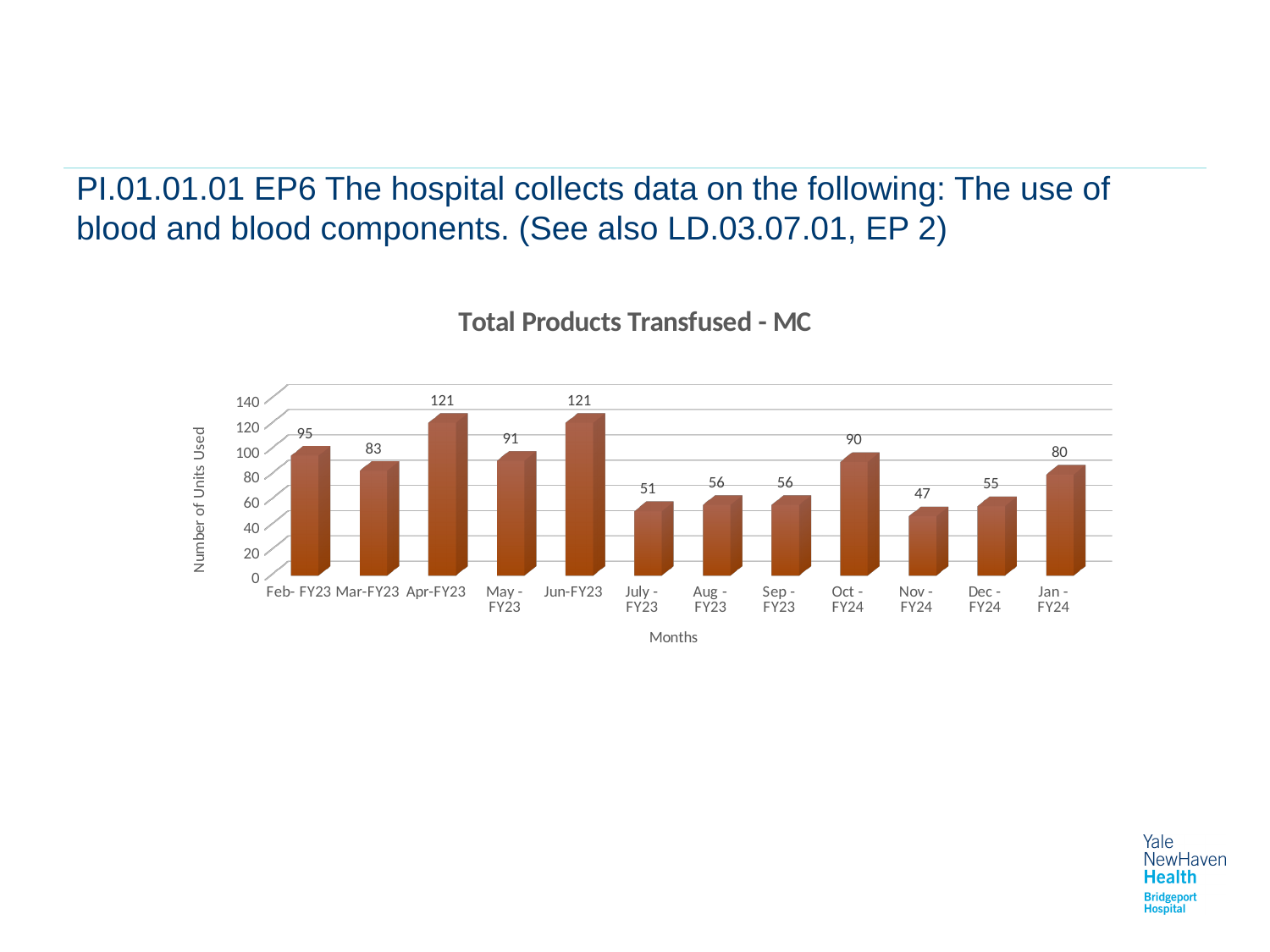
What is the title of the chart? Total Products Transfused - MC What is the highest value shown on the chart? 121 What is the difference between the units used in Apr-FY23 and Mar-FY23? 38 Which month has the lowest number of units used? Nov-FY24 How many months are plotted on the chart? 12 What type of chart is shown on the slide? bar chart What is the label of the vertical axis? Number of Units Used What is the number of units used in Nov-FY24? 47 Which is larger, the value for Jan-FY24 or the value for Dec-FY24? Jan-FY24 What is the number of units used in Feb-FY23? 95 Is the value for Jun-FY23 greater or less than 100? greater What is the number of units used in Oct-FY24? 90